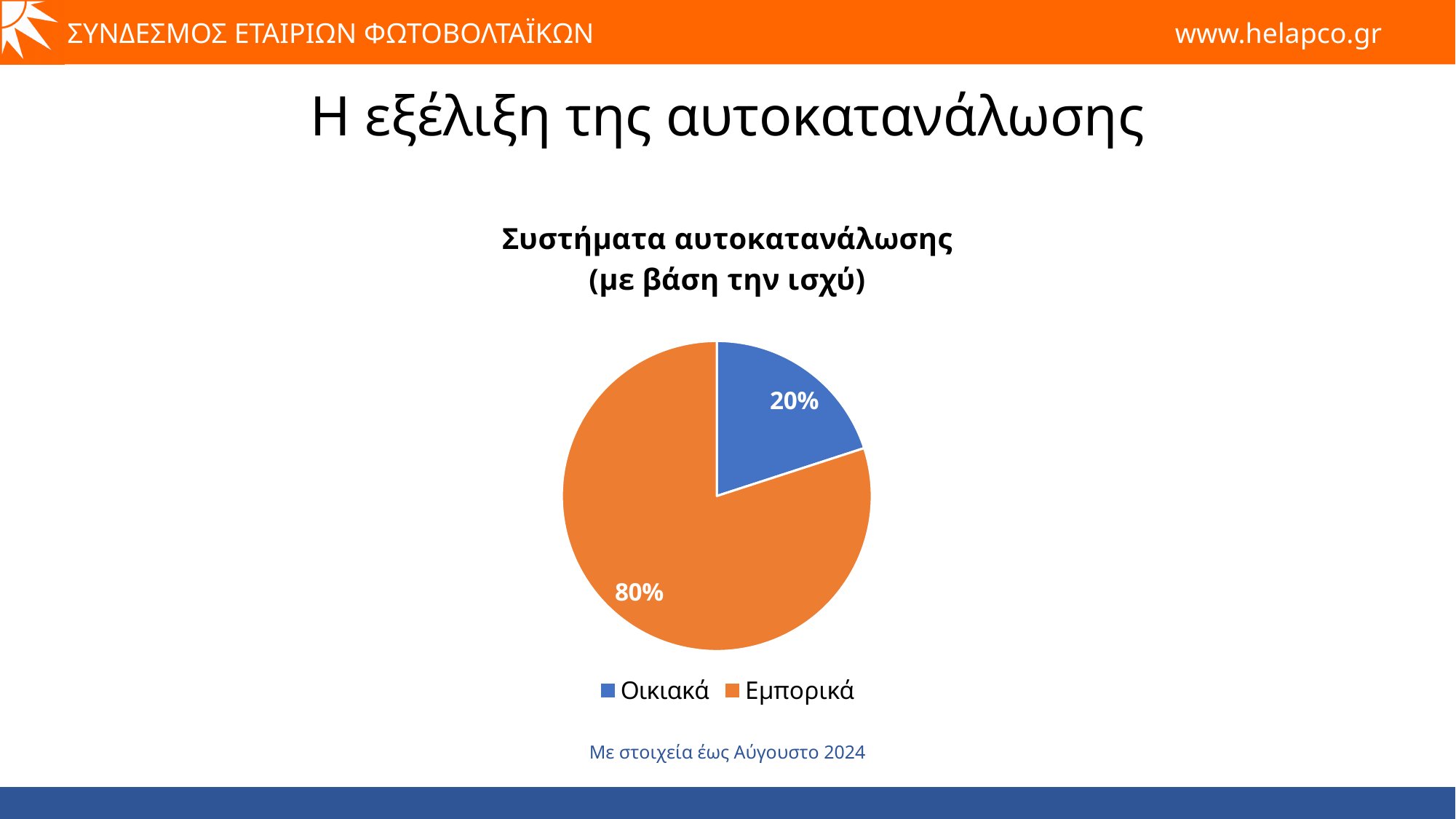
What is the title of the chart? Συστήματα αυτοκατανάλωσης (με βάση την ισχύ) Which category has the largest slice of the pie? Εμπορικά Which category has the smallest slice of the pie? Οικιακά How many categories does the pie chart show? 2 What share of the pie does Οικιακά represent? 20% How many entries does the legend list? 2 What share of the pie does Εμπορικά represent? 80% What is the difference in percentage points between the Εμπορικά and Οικιακά slices? 60 What kind of chart is shown on the slide? pie chart What colour is the Οικιακά slice? blue Which is larger, the Οικιακά slice or the Εμπορικά slice? Εμπορικά